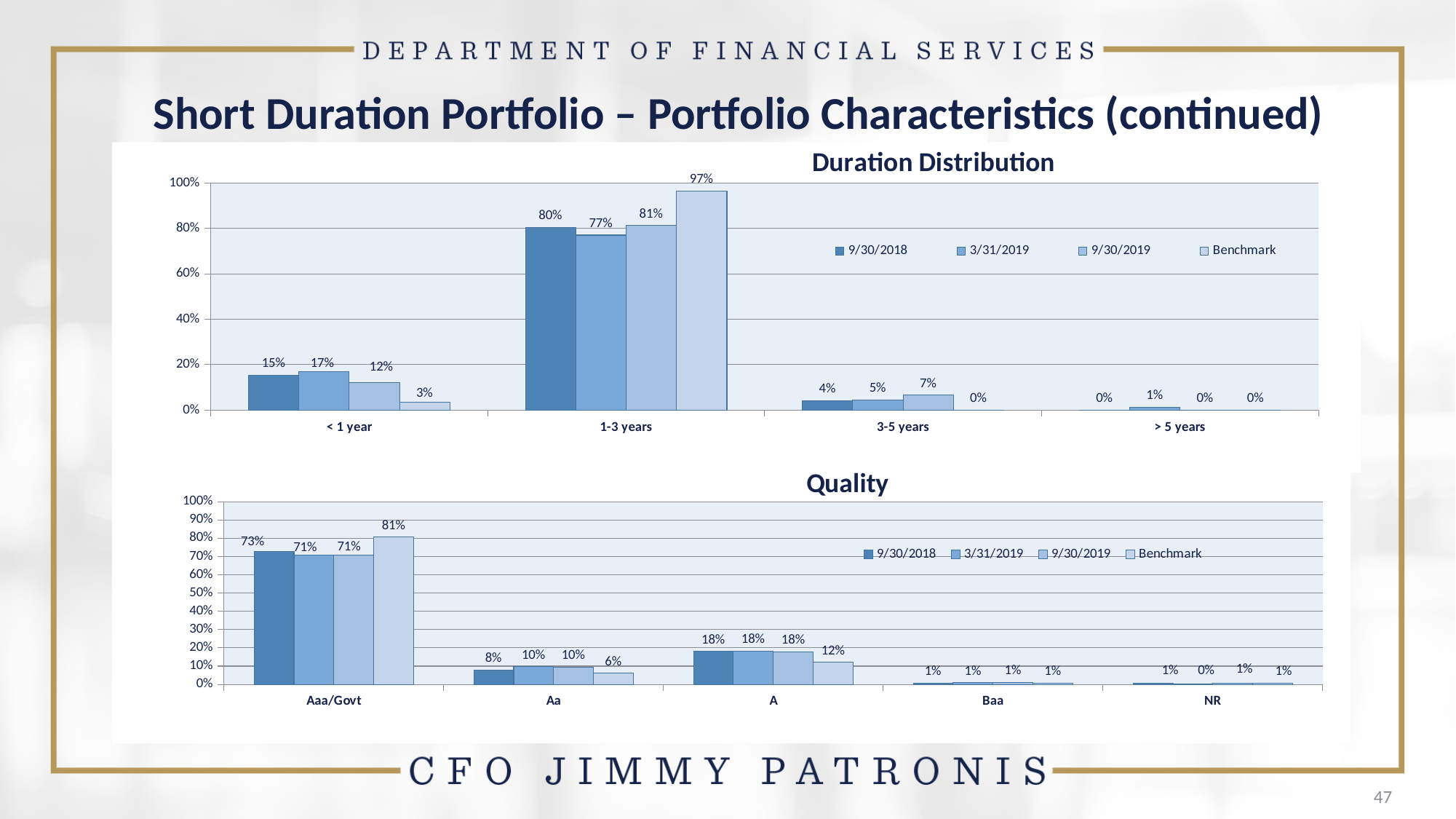
In the Quality chart, what is the Benchmark value for Aaa/Govt? 81% What type of chart is the Quality chart? Bar chart In the Quality chart, what is the difference between the Benchmark and 9/30/2018 values for Aaa/Govt? 8% In the Duration Distribution chart, how many duration categories are shown on the x axis? 4 In the Duration Distribution chart, what is the 9/30/2019 value for < 1 year? 12% In the Quality chart, what is the 9/30/2019 value for Aa? 10% In the Quality chart, which rating category has the lowest 3/31/2019 value? NR In the Duration Distribution chart, what is the Benchmark value for 1-3 years? 97% In the Duration Distribution chart, which duration bucket has the highest 9/30/2018 value? 1-3 years In the Duration Distribution chart, how many series does the legend list? 4 In the Duration Distribution chart, what is the difference between the 3/31/2019 and 9/30/2018 values for < 1 year? 2% In the Quality chart, which is larger for the A category: the 9/30/2018 value or the Benchmark value? 9/30/2018